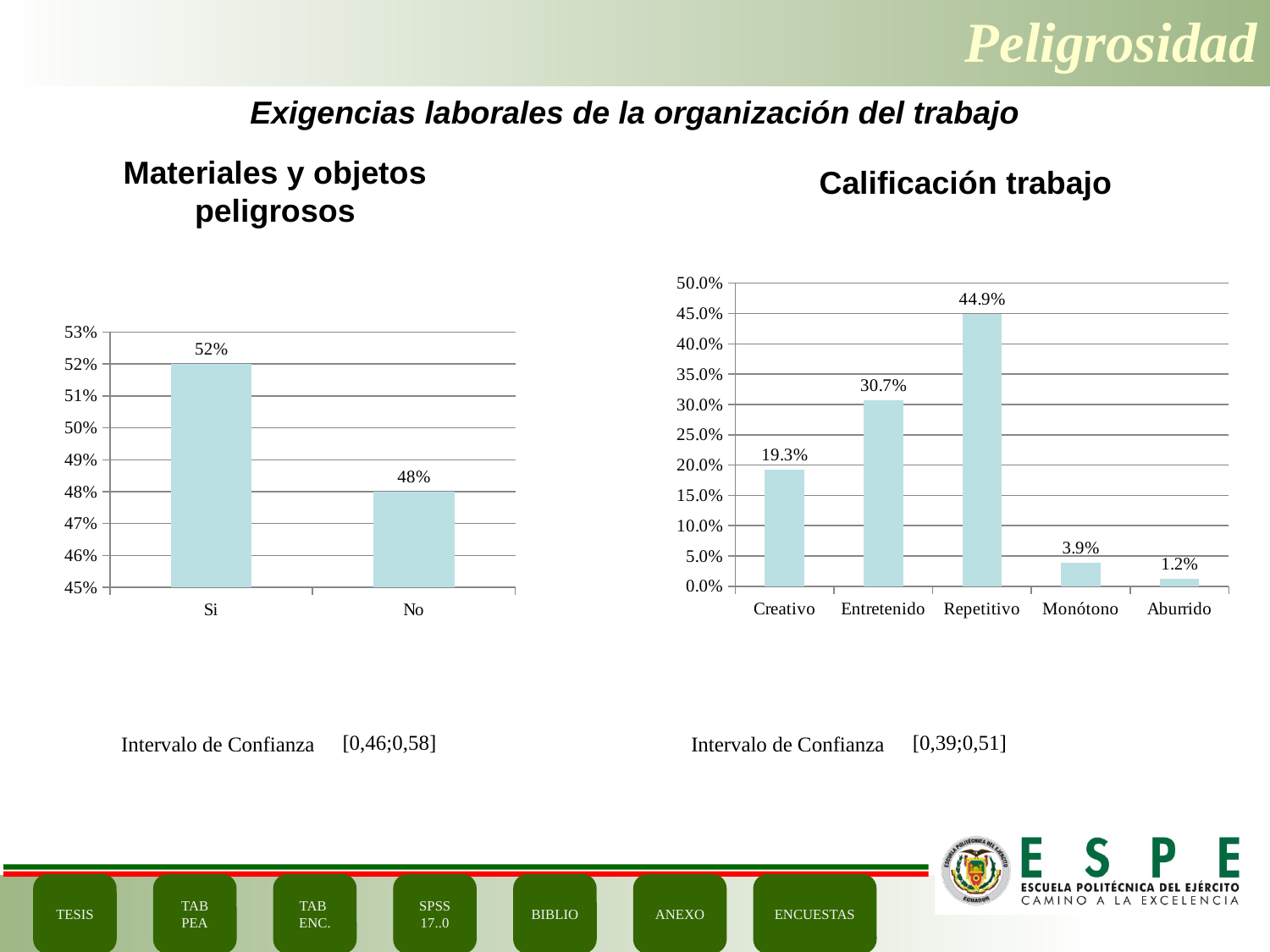
In the 'Calificación trabajo' chart, which category has the highest value? Repetitivo What kind of chart is the 'Calificación trabajo' chart? Bar chart In the 'Materiales y objetos peligrosos' chart, what is the value for No? 48% In the 'Materiales y objetos peligrosos' chart, what is the value for Si? 52% In the 'Calificación trabajo' chart, which is larger, Monótono or Aburrido? Monótono In the 'Materiales y objetos peligrosos' chart, how many categories are shown? 2 In the 'Calificación trabajo' chart, what is the value for Creativo? 19.3% In the 'Calificación trabajo' chart, which category has the lowest value? Aburrido In the 'Materiales y objetos peligrosos' chart, what is the difference between the Si and No values? 4% In the 'Calificación trabajo' chart, how many categories are shown on the x axis? 5 In the 'Calificación trabajo' chart, what is the value for Repetitivo? 44.9% In the 'Calificación trabajo' chart, what is the difference between Repetitivo and Entretenido? 14.2%